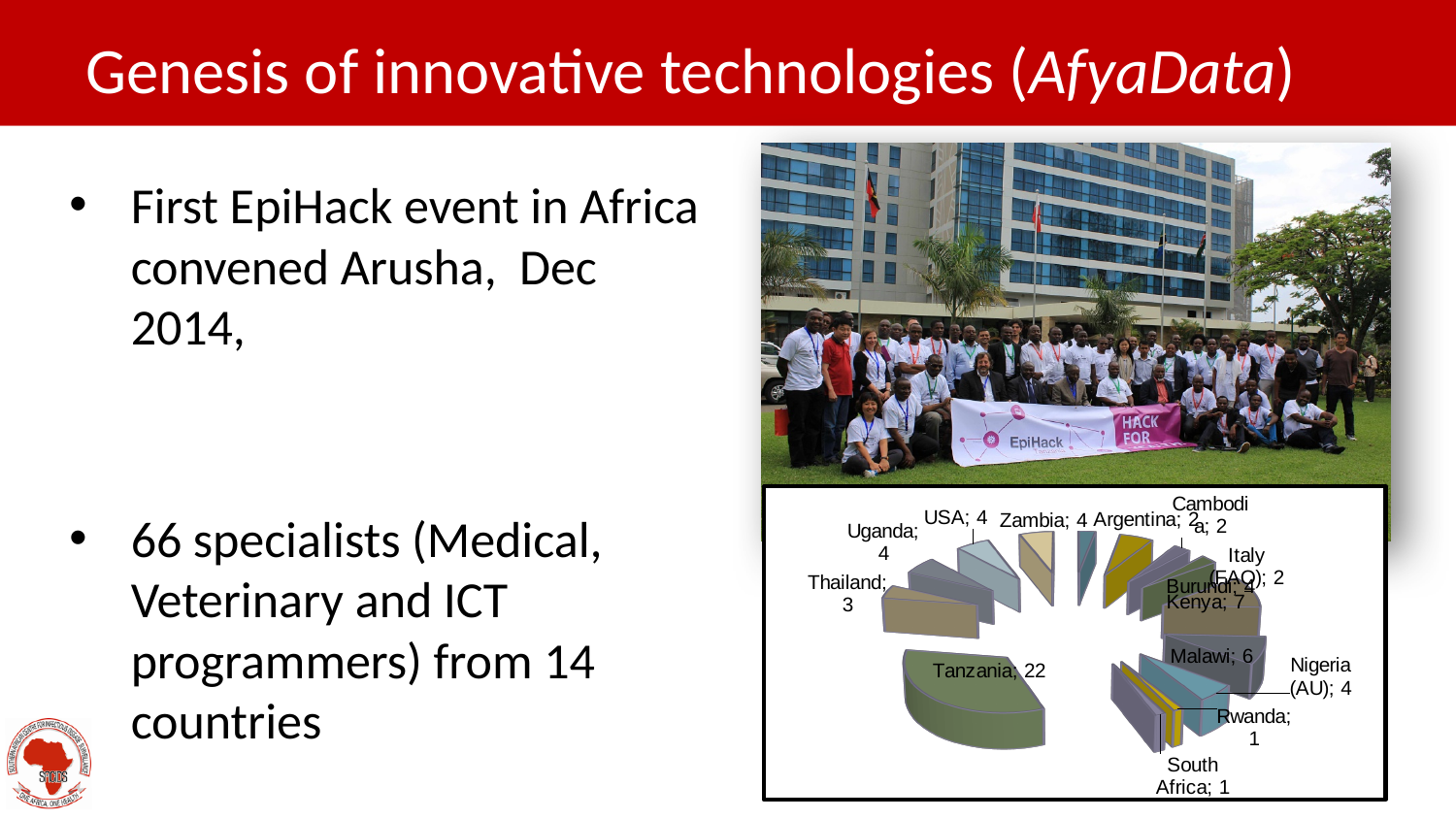
What is the value for Kenya in the pie chart? 7 Which country has the largest slice in the pie chart? Tanzania What is the value for Thailand in the pie chart? 3 What kind of chart is shown on the slide? Pie chart What is the value for Nigeria (AU) in the pie chart? 4 What is the value for Rwanda in the pie chart? 1 What is the difference between the values for Tanzania and Kenya in the pie chart? 15 Which has the larger value in the pie chart, Kenya or Malawi? Kenya What is the value for Tanzania in the pie chart? 22 What is the value for Malawi in the pie chart? 6 How many countries are shown as slices in the pie chart? 14 Which has the larger value in the pie chart, Tanzania or Uganda? Tanzania